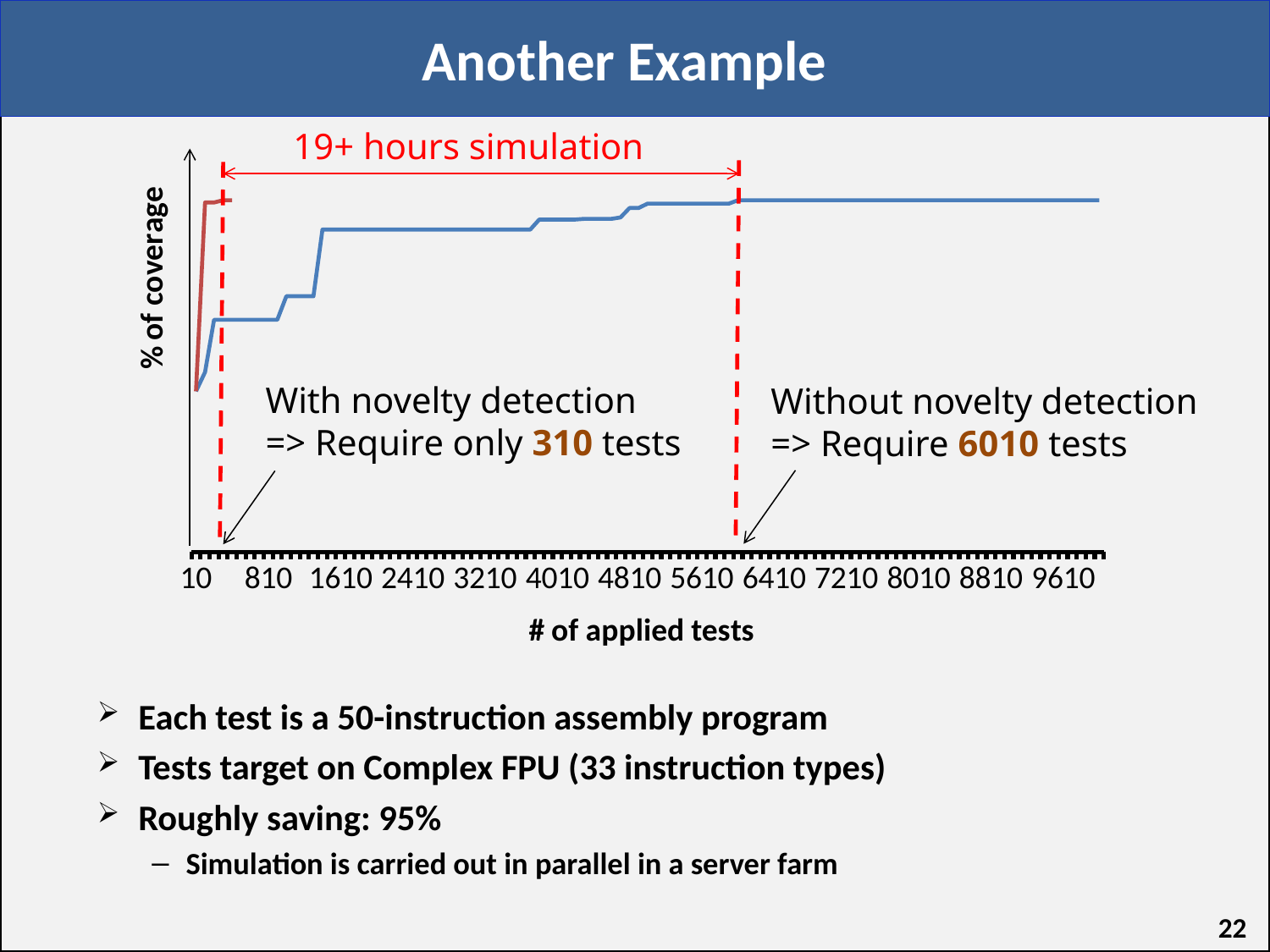
What is the label of the x axis of the chart? # of applied tests According to the chart annotation, how many tests are required without novelty detection? 6010 Which requires more tests to reach the coverage level: with novelty detection or without novelty detection? Without novelty detection How many tick labels are printed along the x axis of the chart? 13 What is the label of the y axis of the chart? % of coverage How much simulation time does the red arrow annotation on the chart indicate? 19+ hours simulation What is the largest tick label printed on the x axis of the chart? 9610 How many lines are plotted on the chart? 2 How many more tests are required without novelty detection than with novelty detection? 5700 According to the chart annotation, how many tests are required with novelty detection? 310 Does the blue line's coverage rise or fall as the number of applied tests increases? rise What kind of chart is shown on the slide? line chart